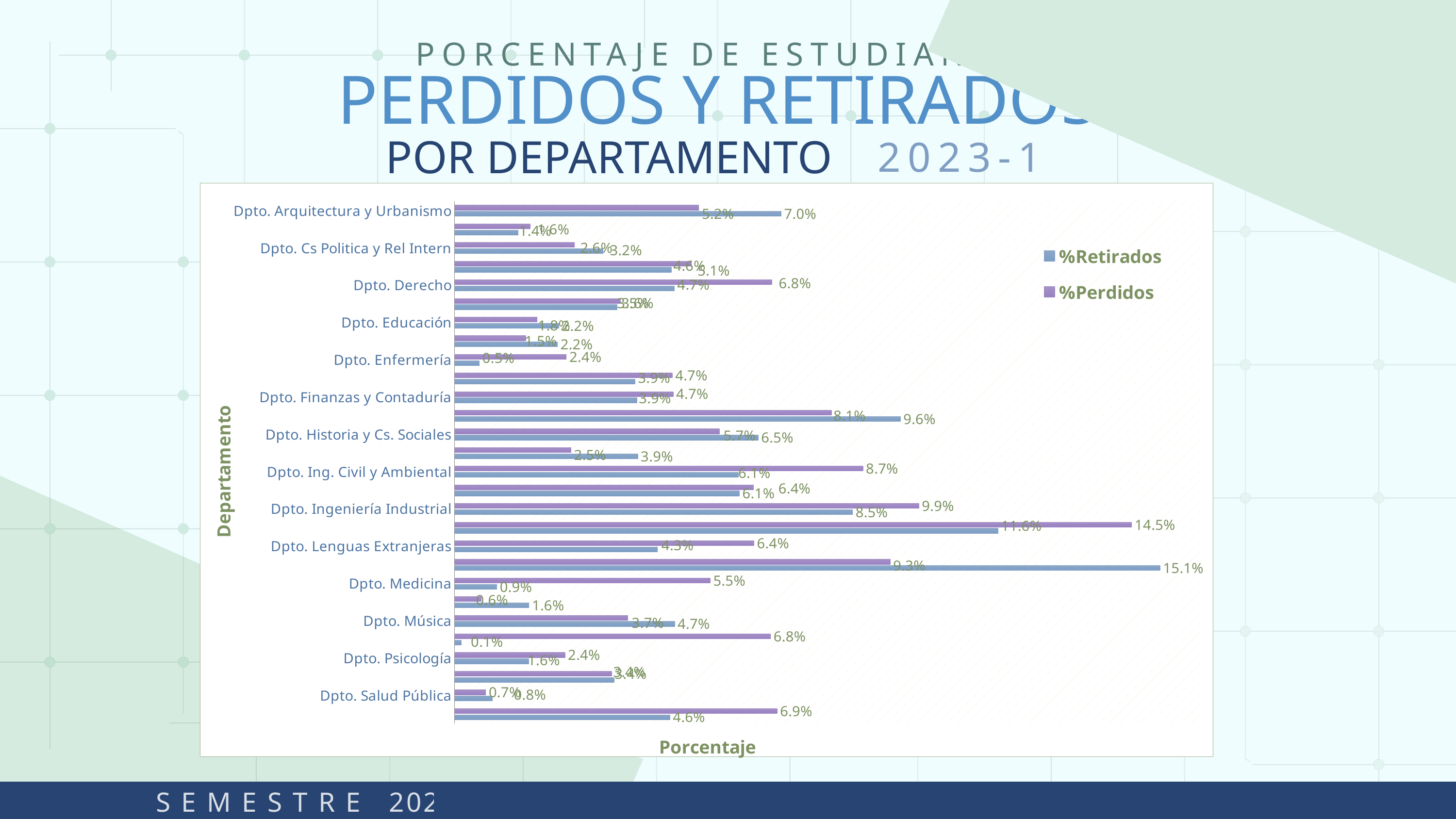
For Dpto. Enfermería, which series has the larger value, %Retirados or %Perdidos? %Perdidos What is the %Retirados value for Dpto. Lenguas Extranjeras? 4.3% What is the %Perdidos value for Dpto. Ingeniería Industrial? 9.9% What is the %Retirados value for Dpto. Arquitectura y Urbanismo? 7.0% How many series does the chart legend list? 2 What is the highest %Perdidos value labelled on the chart? 14.5% What is the %Perdidos value for Dpto. Derecho? 6.8% What are the two series named in the legend? %Retirados and %Perdidos What type of chart is shown on the slide? bar chart What is the %Retirados value for Dpto. Medicina? 0.9% What is the highest %Retirados value labelled on the chart? 15.1% For Dpto. Ing. Civil y Ambiental, how much larger is %Perdidos (8.7%) than %Retirados (6.1%)? 2.6%